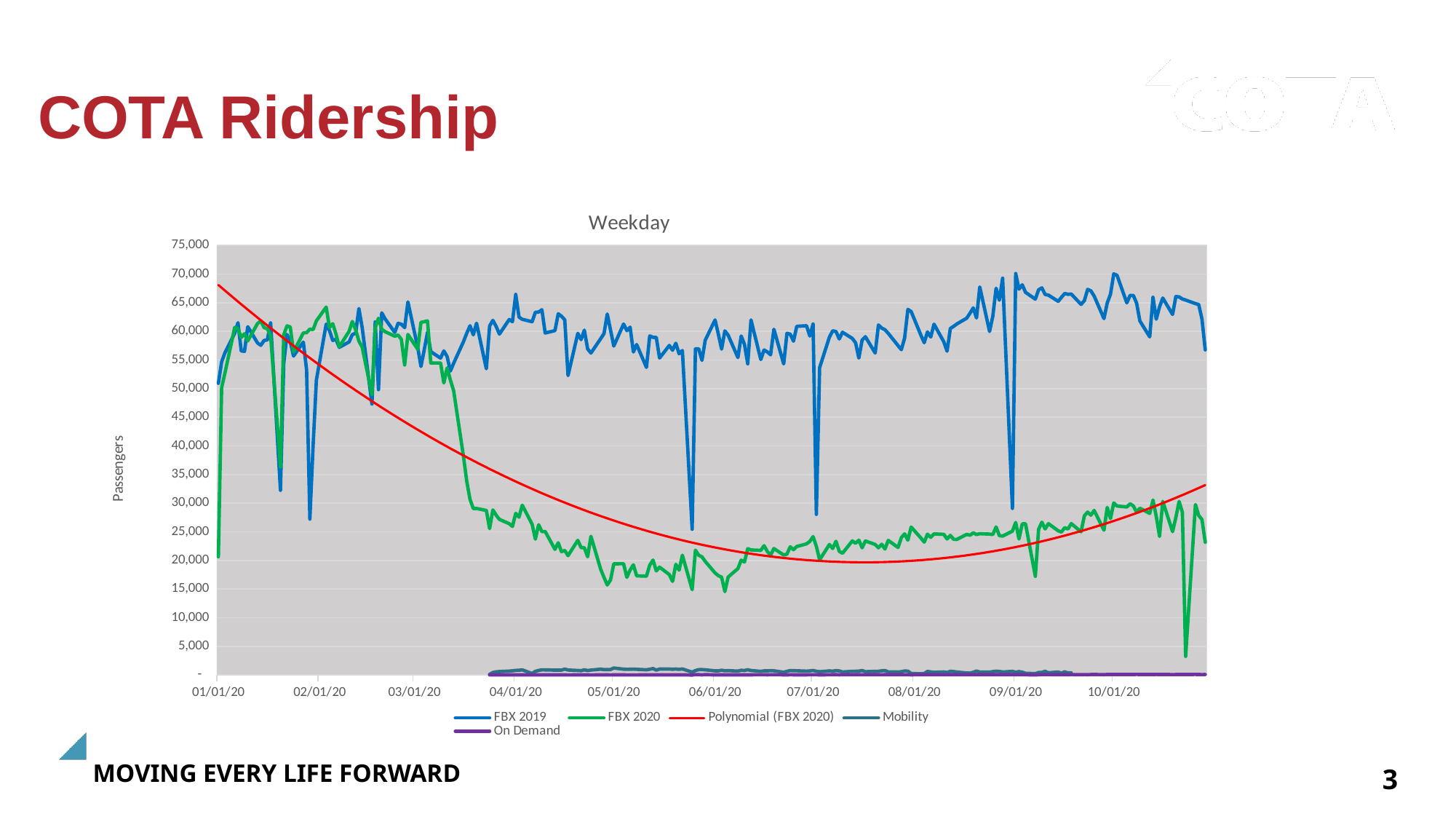
Is the FBX 2019 value at 08/01/20 greater or less than 50,000? greater What is the title of the chart? Weekday How many series does the legend list? 5 At 06/01/20, which series is larger, FBX 2019 or FBX 2020? FBX 2019 What kind of chart is shown on the slide? line chart Is the Polynomial (FBX 2020) value at 01/01/20 greater or less than 65,000? greater Is the FBX 2019 value at 10/01/20 greater or less than 60,000? greater What is the label on the vertical axis? Passengers Does the FBX 2020 line rise or fall between 03/01/20 and 05/01/20? fall